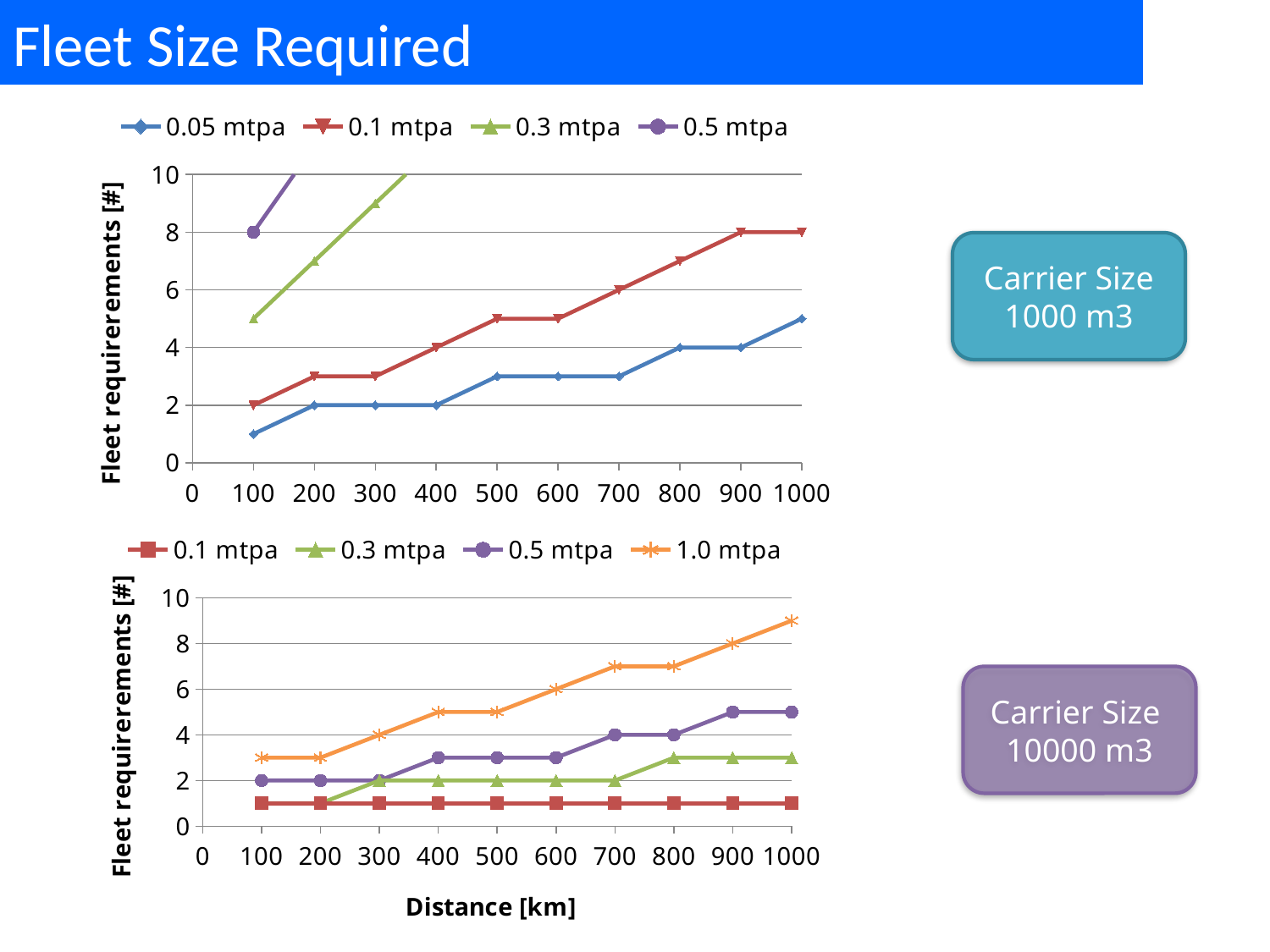
In the top chart (Carrier Size 1000 m3), what is the fleet requirement for 0.5 mtpa at 100 km? 8 In the top chart (Carrier Size 1000 m3), what is the fleet requirement for 0.05 mtpa at 200 km? 2 In the top chart (Carrier Size 1000 m3), is the fleet requirement for 0.05 mtpa at 1000 km greater or less than 4? greater In the top chart (Carrier Size 1000 m3), how many series does the legend list? 4 In the bottom chart (Carrier Size 10000 m3), what is the fleet requirement for 1.0 mtpa at 600 km? 6 What is the x-axis title of the bottom chart? Distance [km] In the top chart (Carrier Size 1000 m3), what is the fleet requirement for 0.1 mtpa at 1000 km? 8 In the bottom chart (Carrier Size 10000 m3), what is the fleet requirement for 0.5 mtpa at 700 km? 4 In the bottom chart (Carrier Size 10000 m3), which series has the highest fleet requirement at 1000 km? 1.0 mtpa In the bottom chart (Carrier Size 10000 m3), how many series does the legend list? 4 In the bottom chart (Carrier Size 10000 m3), what is the difference between the fleet requirements for 1.0 mtpa and 0.3 mtpa at 600 km? 4 What type of charts are shown on the slide? Line charts